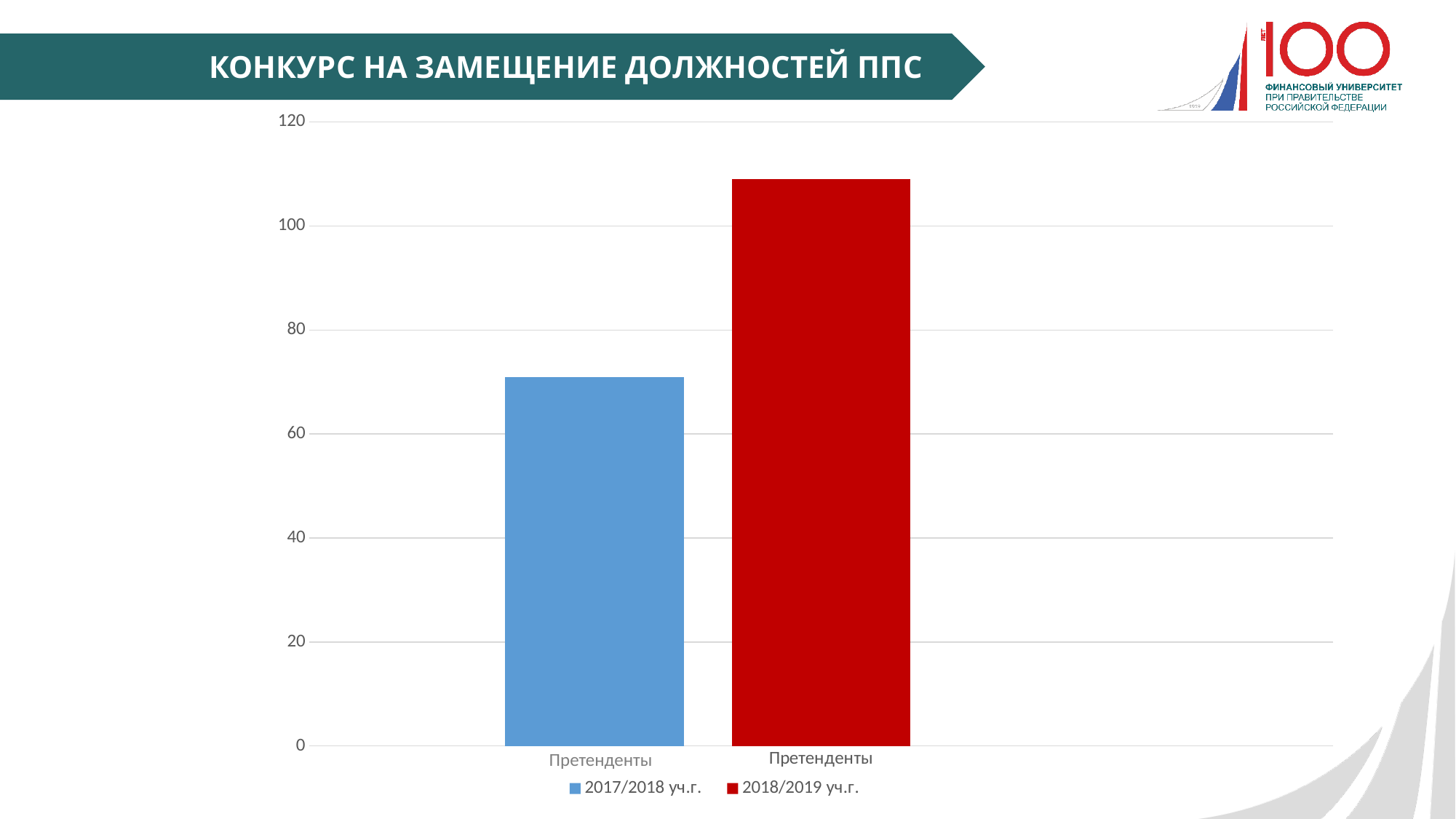
Is the value for 2018/2019 уч.г. greater or less than 120? less What kind of chart is shown on the slide? bar chart Which series has the taller bar, 2017/2018 уч.г. or 2018/2019 уч.г.? 2018/2019 уч.г. Is the value for 2017/2018 уч.г. greater or less than 80? less Is the value for 2017/2018 уч.г. greater or less than 60? greater Did the number of Претенденты rise or fall from 2017/2018 уч.г. to 2018/2019 уч.г.? rise What colour is the bar for 2018/2019 уч.г.? red How many series does the legend list? 2 Which series has the highest value? 2018/2019 уч.г. Which series has the lowest value? 2017/2018 уч.г. What is the title of the slide containing the chart? КОНКУРС НА ЗАМЕЩЕНИЕ ДОЛЖНОСТЕЙ ППС